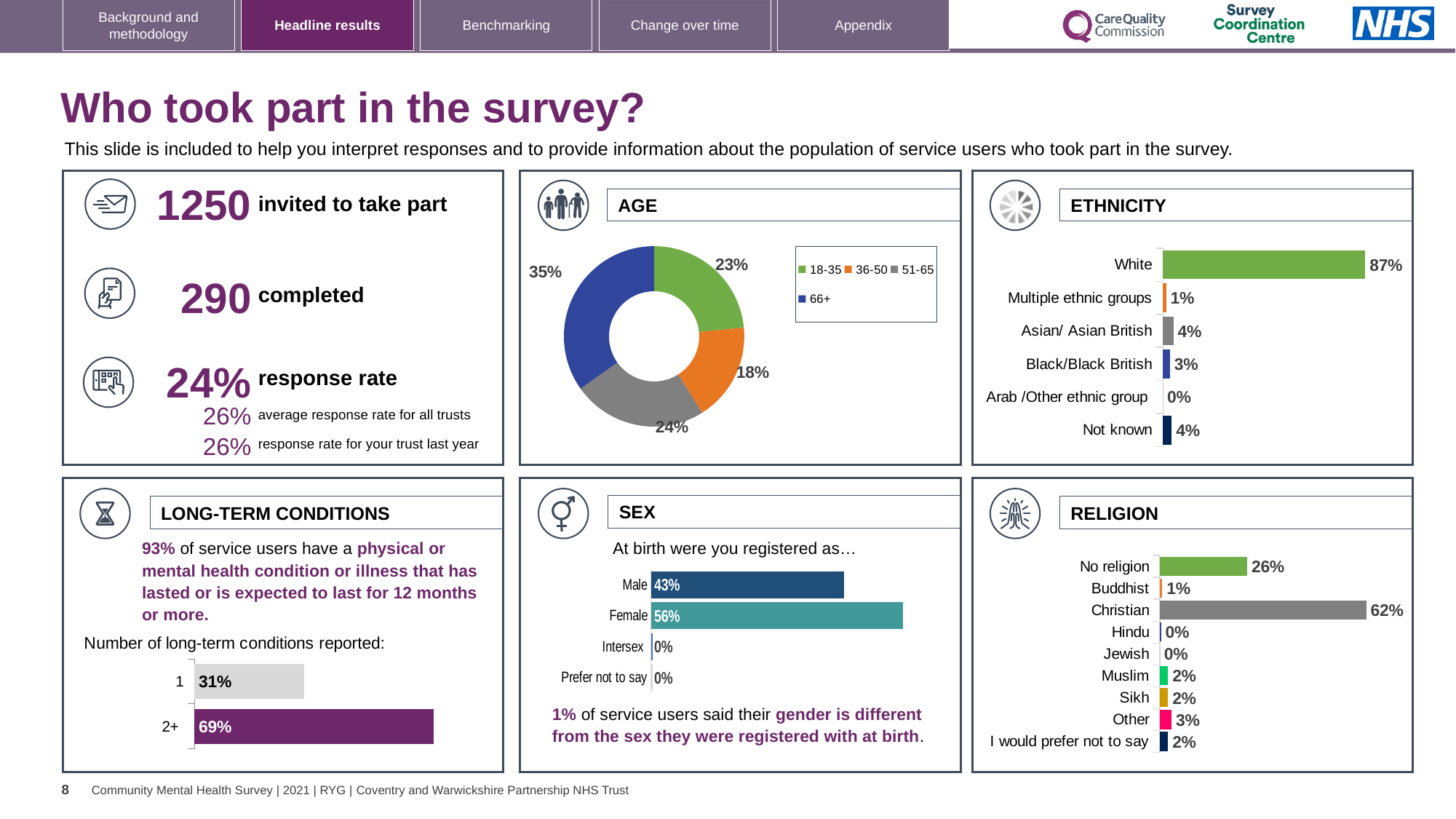
In the ETHNICITY chart, what is the difference between Asian/Asian British and Black/Black British? 1% In the SEX chart, what is the difference between Female and Male? 13% In the LONG-TERM CONDITIONS chart, what percentage of service users reported 2+ conditions? 69% How many age groups does the legend of the AGE chart list? 4 In the SEX chart, which is larger, Male or Female? Female In the RELIGION chart, what is the value for No religion? 26% In the AGE chart, which age group has the smallest share? 36-50 What kind of chart is the AGE chart? Donut chart In the AGE chart, what share of respondents were aged 66+? 35% In the ETHNICITY chart, how many ethnic categories are shown? 6 In the RELIGION chart, which religion category has the highest value? Christian In the ETHNICITY chart, what is the value for White? 87%